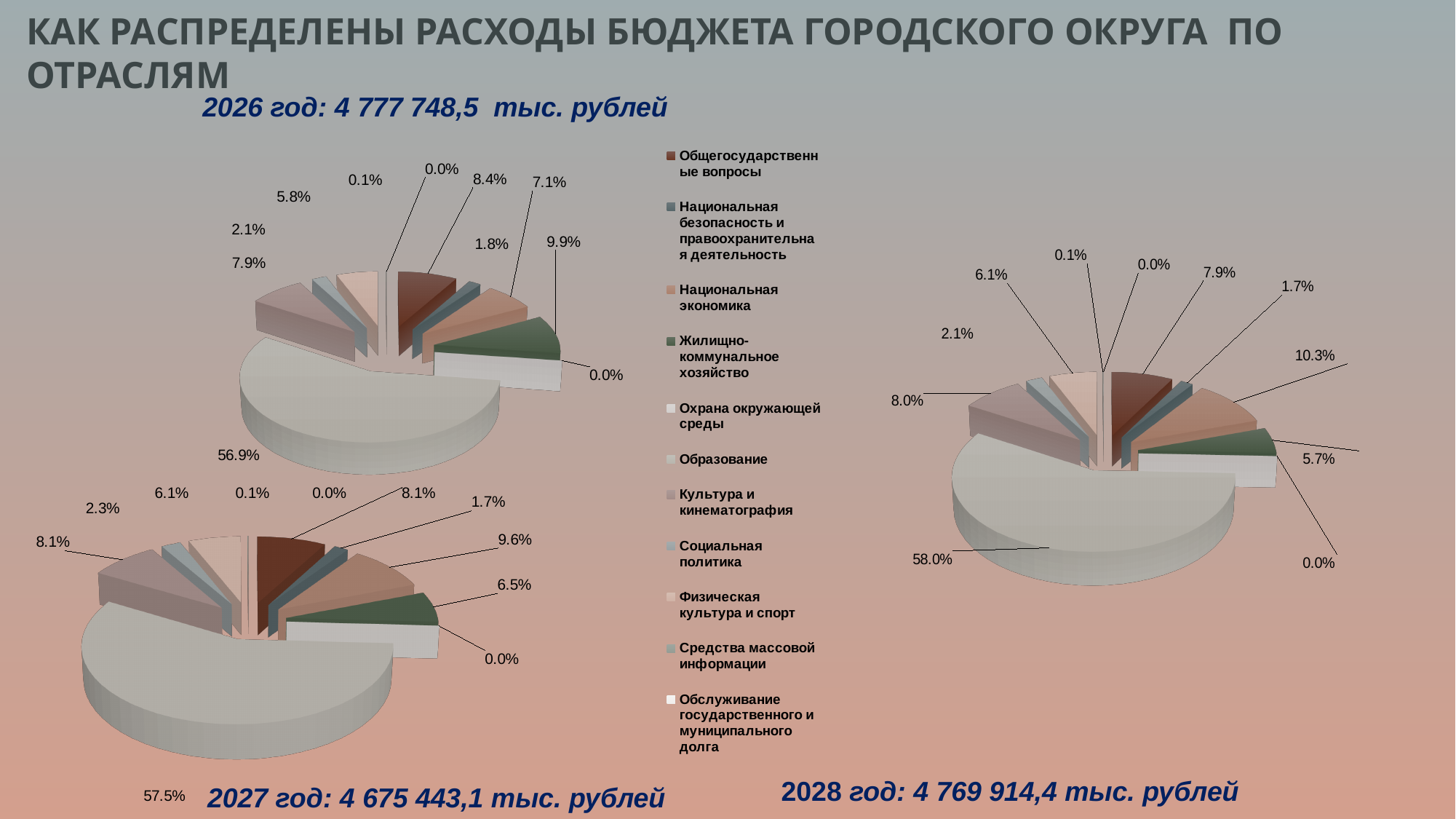
What kind of chart is used to show the 2026 budget expenditure distribution? pie chart In the 2028 chart, what share of expenditure goes to Образование? 58.0% How many categories does the legend list for the expenditure charts? 11 How many pie charts are shown on the slide? 3 In the 2026 chart, what share is shown for Общегосударственные вопросы? 8.4% What total expenditure amount is given for 2027? 4 675 443,1 тыс. рублей In the 2028 chart, what share is shown for Национальная экономика? 10.3% What is the difference between the Образование share in 2028 and in 2026? 1.1% In the 2027 chart, what share of expenditure goes to Образование? 57.5% Which year's chart shows a larger share for Образование, 2027 or 2028? 2028 In the 2028 chart, which category has the largest share? Образование In the 2026 chart, what share of expenditure goes to Образование? 56.9%